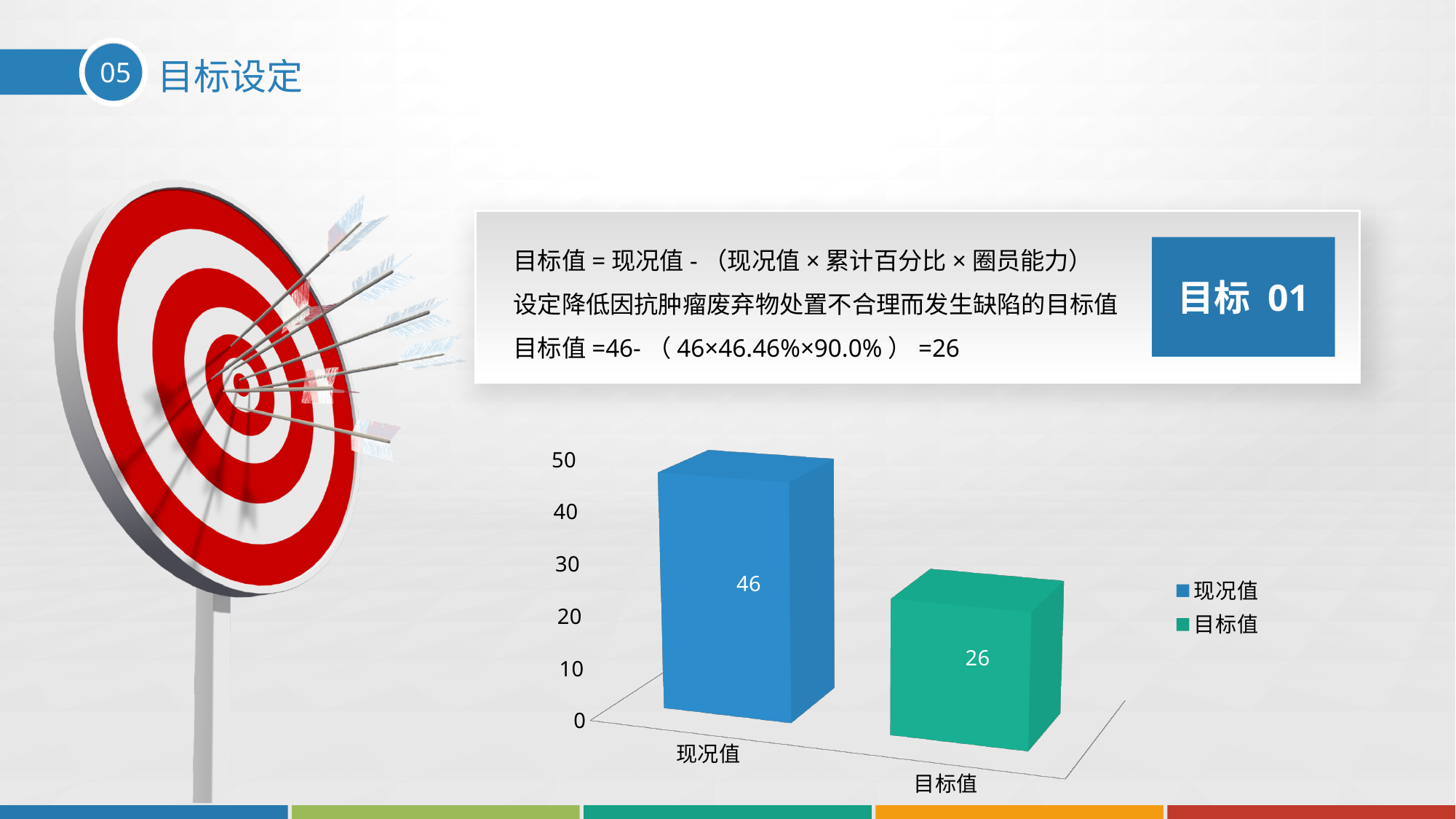
Is the value for 目标值 greater or less than 30? less Which is larger, 现况值 or 目标值? 现况值 What colour is the 目标值 bar? Green How many bars are shown in the chart? 2 How many entries does the legend list? 2 What is the difference between the 现况值 and 目标值 values? 20 What kind of chart is shown on the slide? Bar chart Which category has the lowest value? 目标值 Is the value for 现况值 greater or less than 40? greater What is the value of the 现况值 bar? 46 What is the value of the 目标值 bar? 26 Which category has the highest value? 现况值